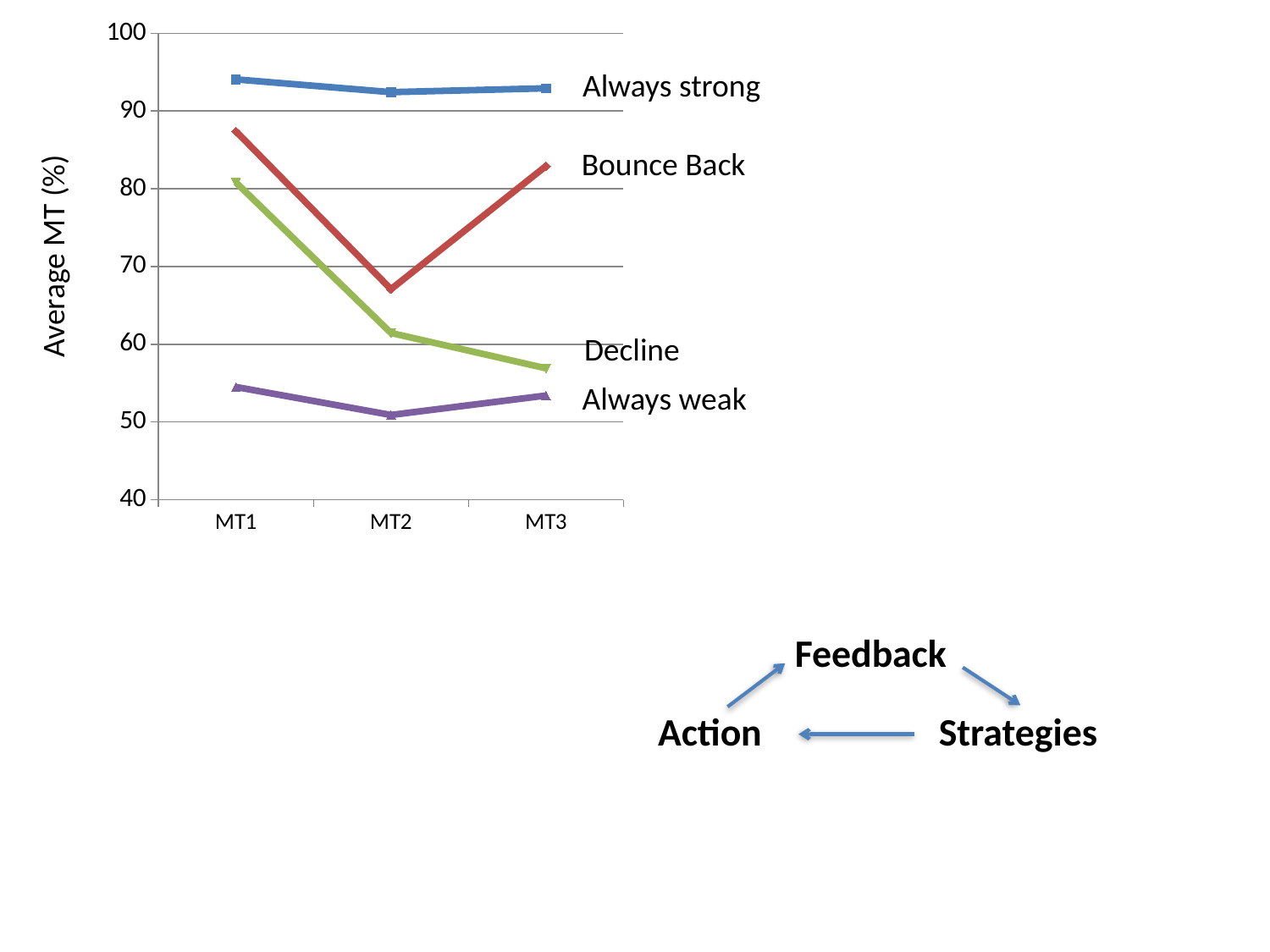
How many series are plotted on the chart? 4 Is the value for Always strong at MT1 greater or less than 90? greater How many points are on the x axis of the chart? 3 Which is larger at MT3, Bounce Back or Decline? Bounce Back Is the value for Decline at MT3 greater or less than 60? less Which series has the lowest value at MT2? Always weak Does the Decline series rise or fall from MT1 to MT3? fall What kind of chart is shown on the slide? line chart What is the label on the y axis of the chart? Average MT (%) Is the value for Bounce Back at MT2 greater or less than 70? less Which series has the highest value at MT1? Always strong